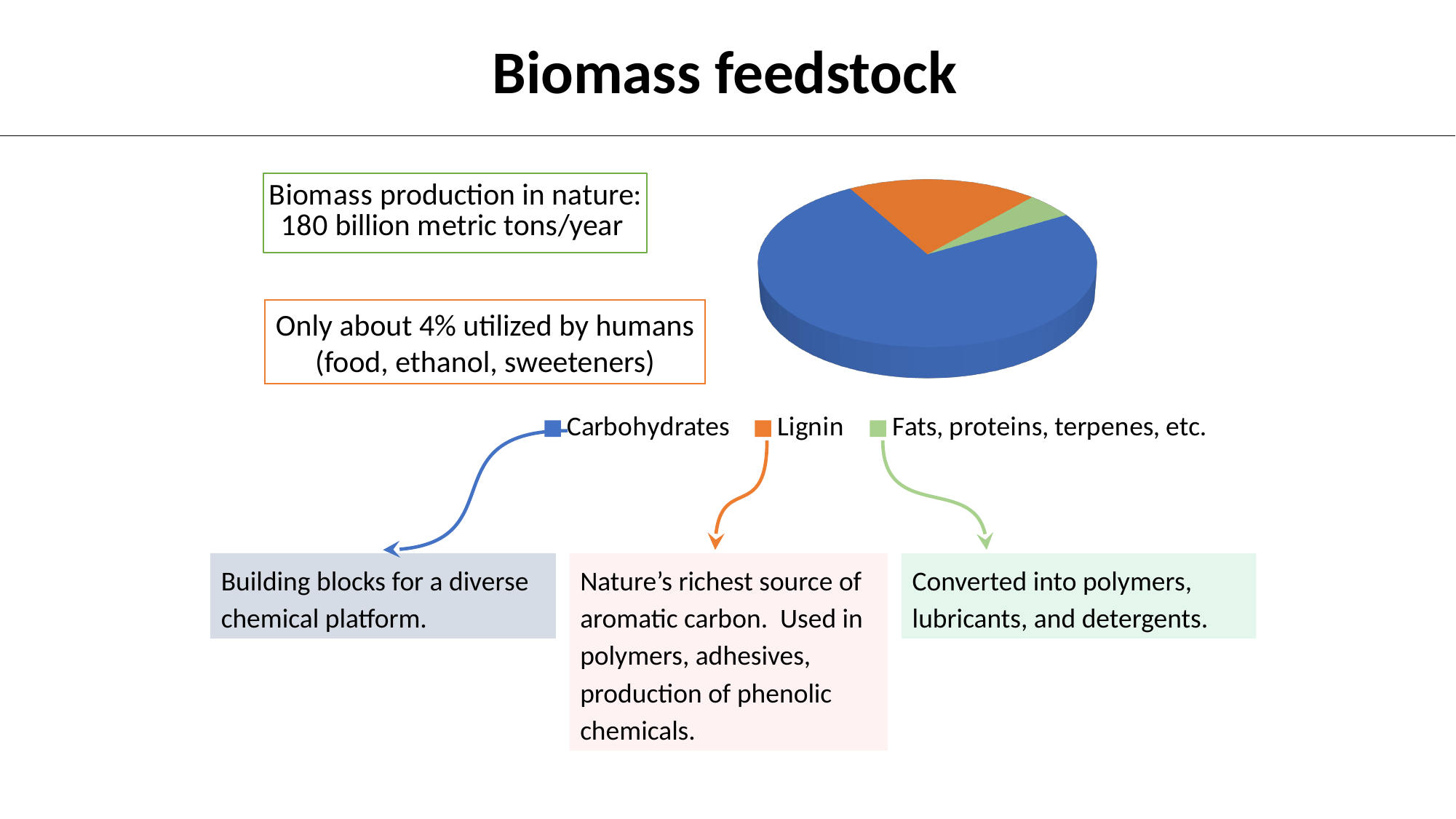
Which category has the smallest slice of the pie chart? Fats, proteins, terpenes, etc. How many entries does the pie chart's legend list? 3 Which category is shown in green in the pie chart? Fats, proteins, terpenes, etc. How many slices does the pie chart have? 3 Which slice is larger in the pie chart, Lignin or Fats, proteins, terpenes, etc.? Lignin What kind of chart is shown on the slide? pie chart Which slice is larger in the pie chart, Carbohydrates or Lignin? Carbohydrates What colour is the Lignin slice in the pie chart? orange Which category has the largest slice of the pie chart? Carbohydrates